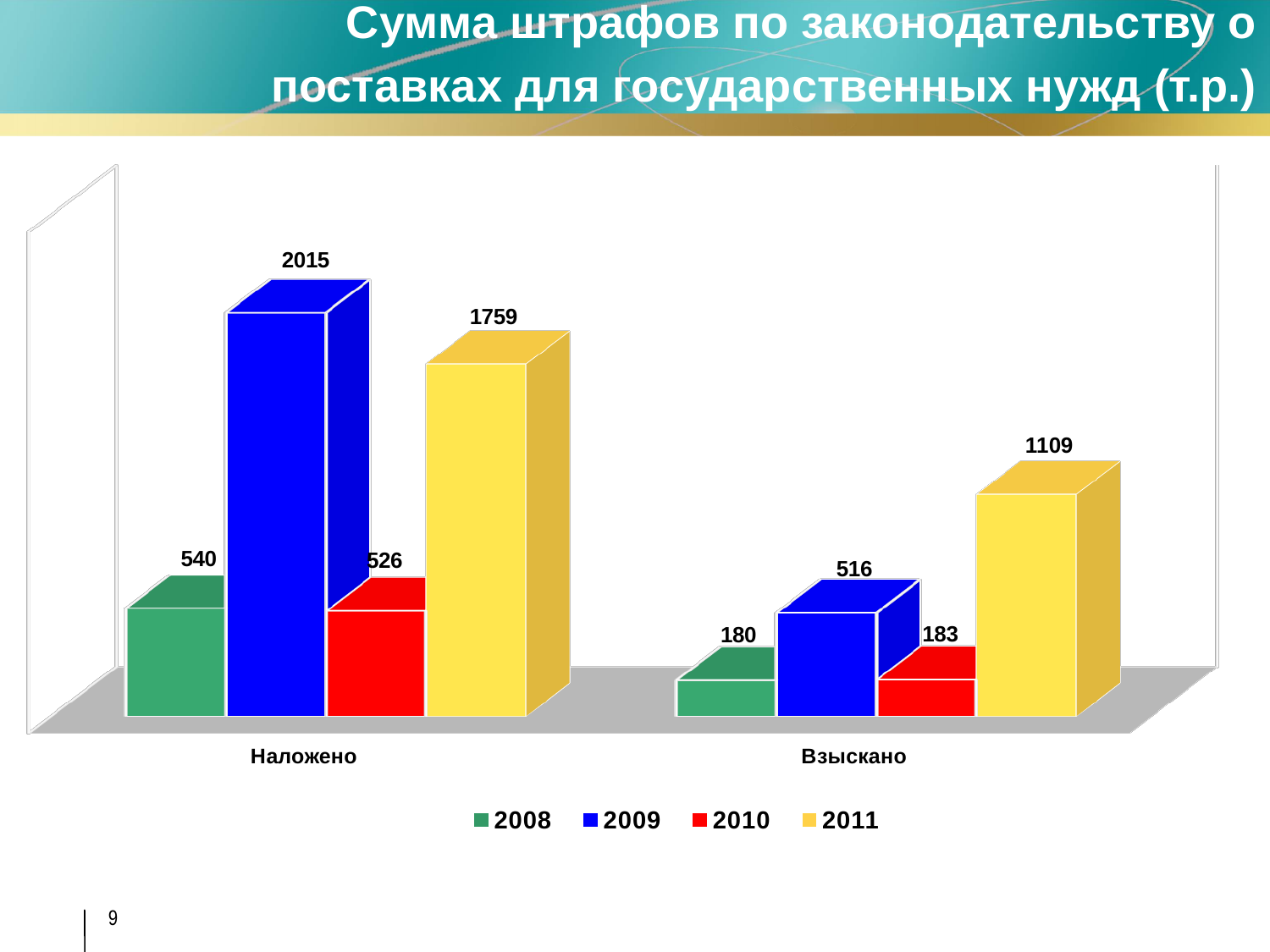
What is the value for 2011 in the Взыскано category? 1109 What is the value for 2009 in the Наложено category? 2015 What is the difference between the 2011 values for Наложено and Взыскано? 650 What is the value for 2010 in the Наложено category? 526 Which is larger: the 2010 value for Взыскано or the 2008 value for Взыскано? 2010 value for Взыскано How many categories are shown on the x axis? 2 What kind of chart is shown on the slide? Bar chart Which year has the highest value in the Наложено category? 2009 What is the value for 2008 in the Взыскано category? 180 What is the difference between the 2009 and 2011 values in the Наложено category? 256 How many series does the legend list? 4 Which year has the lowest value in the Взыскано category? 2008